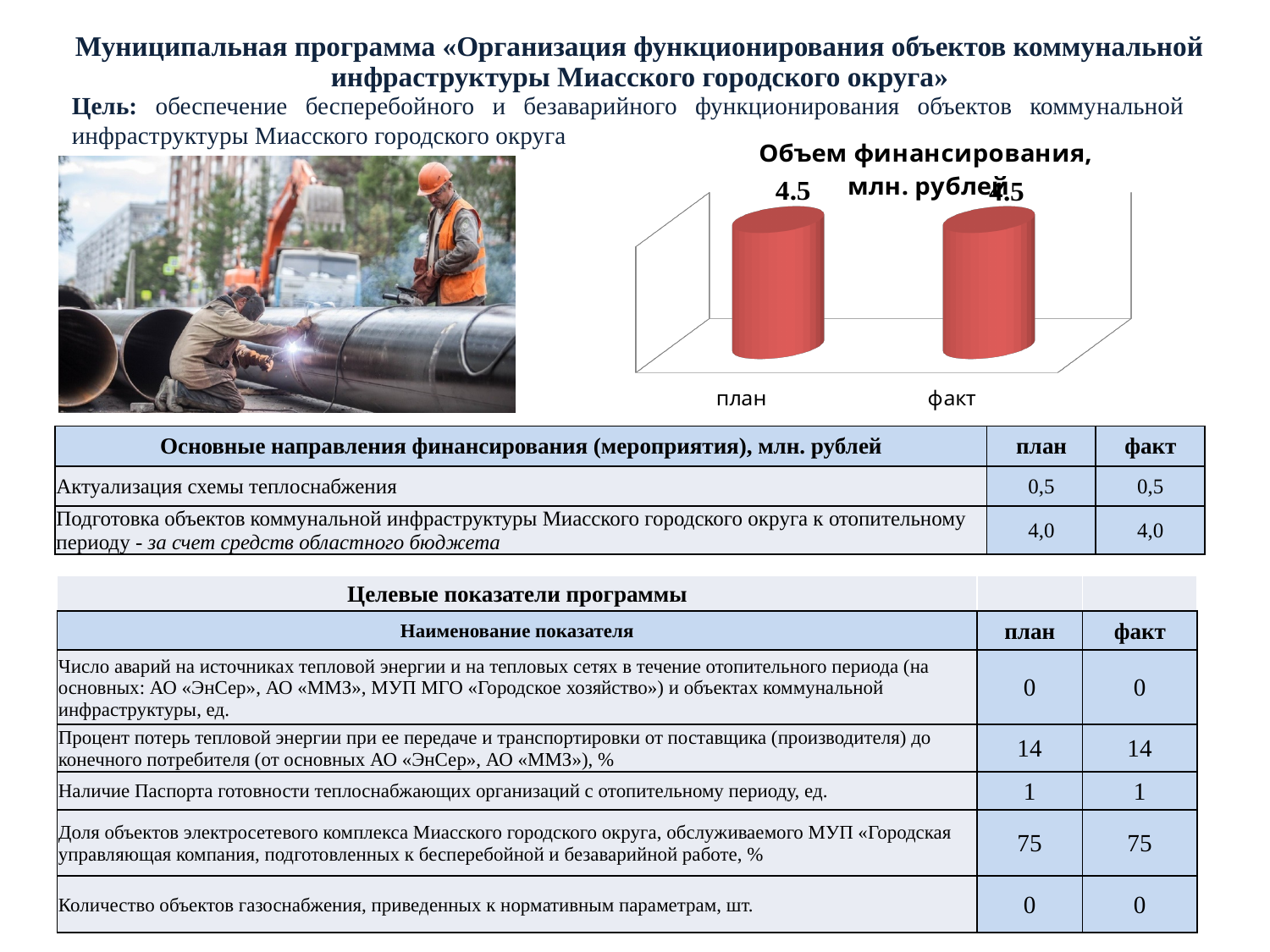
In the chart 'Объем финансирования, млн. рублей', what is the difference between the план and факт values? 0 How many categories are shown in the chart 'Объем финансирования, млн. рублей'? 2 In the chart 'Объем финансирования, млн. рублей', what is the value for факт? 4.5 In the chart 'Объем финансирования, млн. рублей', what is the value for план? 4.5 What are the two category labels on the x axis of the chart 'Объем финансирования, млн. рублей'? план, факт In the chart 'Объем финансирования, млн. рублей', do the values rise, fall or stay the same from план to факт? stay the same What is the title of the chart on the slide? Объем финансирования, млн. рублей What kind of chart is 'Объем финансирования, млн. рублей'? bar chart